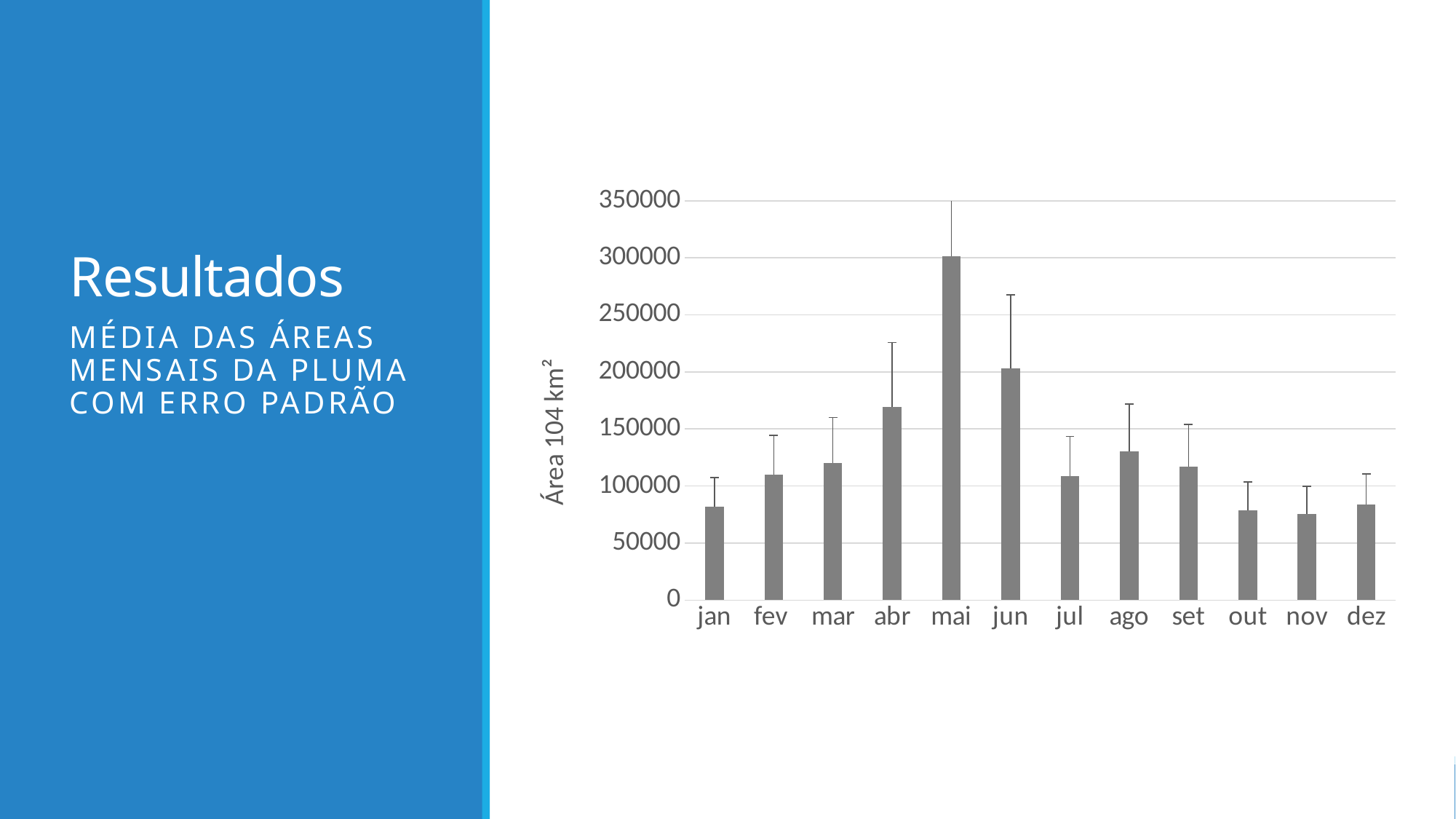
What kind of chart is shown on the slide? bar chart How many months are shown on the x axis of the chart? 12 Which is larger, the value for abr or the value for ago? abr Is the value for mai greater or less than 250000? greater Is the value for ago greater or less than 100000? greater Is the value for out greater or less than 100000? less Which month has the highest bar in the chart? mai Which is larger, the value for mai or the value for jun? mai What is the label on the y axis of the chart? Área 104 km² Do the values rise or fall from jan to mai? rise